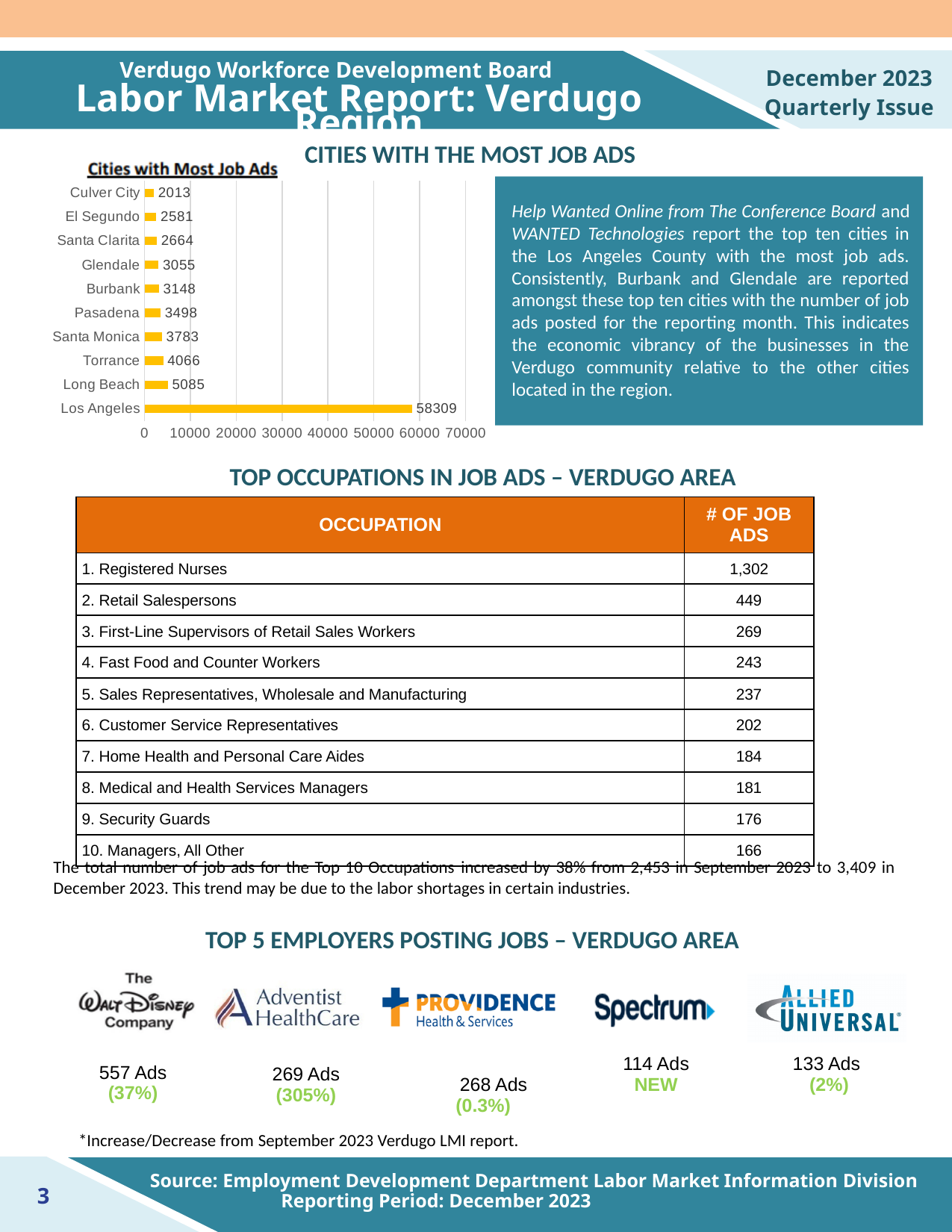
How many cities are shown in the Cities with Most Job Ads chart? 10 What is the number of job ads for Los Angeles in the Cities with Most Job Ads chart? 58309 In the Cities with Most Job Ads chart, which has more job ads, Pasadena or Santa Monica? Santa Monica What is the number of job ads for Burbank in the Cities with Most Job Ads chart? 3148 What type of chart is the Cities with Most Job Ads chart? Bar chart What is the difference in job ads between Burbank and Glendale in the Cities with Most Job Ads chart? 93 What is the difference in job ads between Long Beach and Torrance in the Cities with Most Job Ads chart? 1019 Is the value for Torrance in the Cities with Most Job Ads chart greater or less than 10000? less Which city has the most job ads in the Cities with Most Job Ads chart? Los Angeles What is the number of job ads for Glendale in the Cities with Most Job Ads chart? 3055 What is the number of job ads for Long Beach in the Cities with Most Job Ads chart? 5085 Which city has the fewest job ads in the Cities with Most Job Ads chart? Culver City